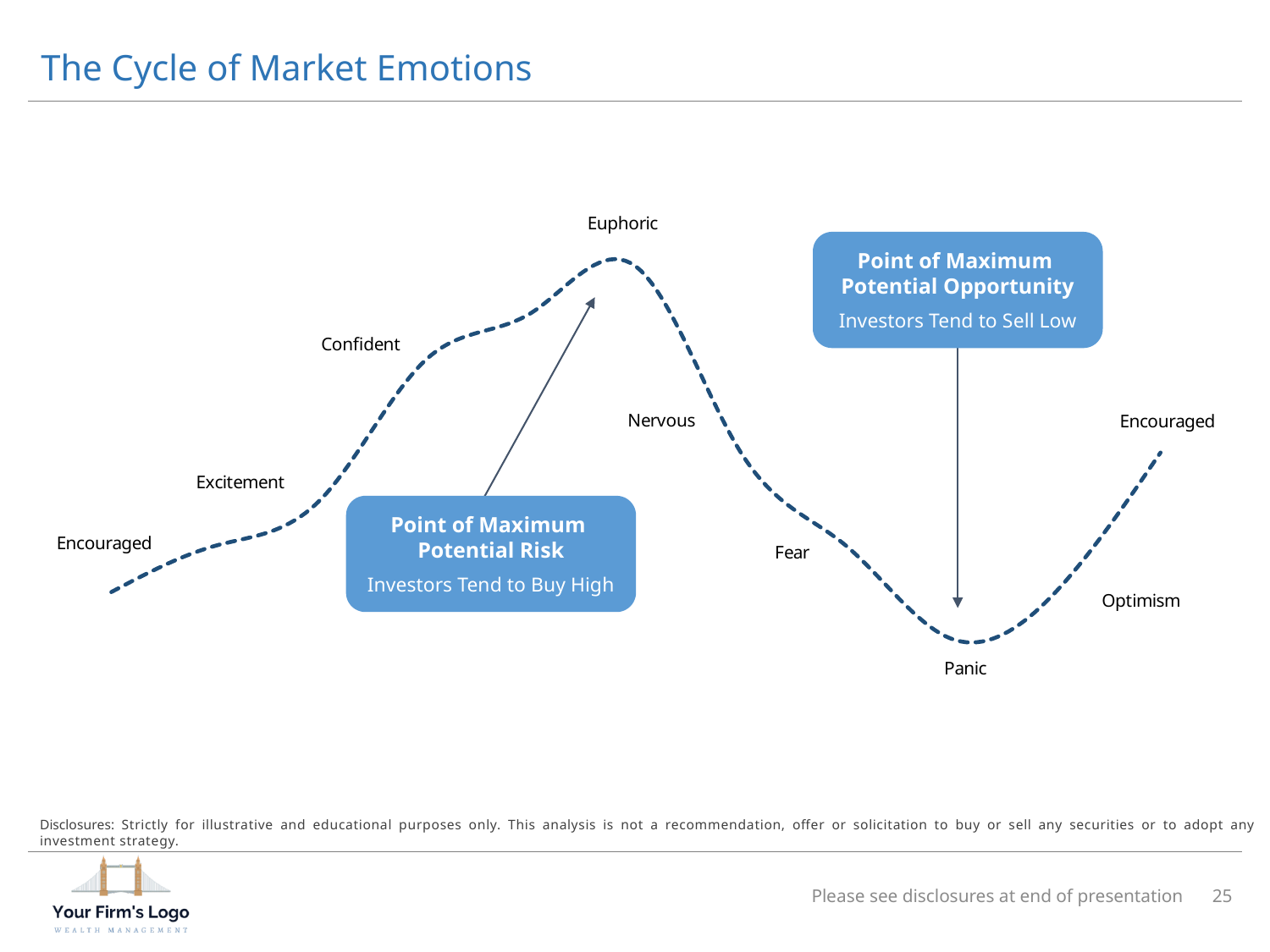
Which emotion label does the 'Point of Maximum Potential Opportunity' arrow point to? Panic Which emotion label sits at the highest point of the curve? Euphoric What kind of chart is shown on the slide? Line chart Does the curve rise or fall between Euphoric and Panic? Fall Does the curve rise or fall between Encouraged (left) and Euphoric? Rise Does the curve rise or fall between Panic and Optimism? Rise How many emotion labels are placed along the curve? 9 Which emotion label sits at the lowest point of the curve? Panic Which emotion label comes immediately after Nervous along the curve? Fear What is the title of the chart on the slide? The Cycle of Market Emotions Which point on the curve is lower, Excitement or Panic? Panic Which point on the curve is higher, Confident or Fear? Confident